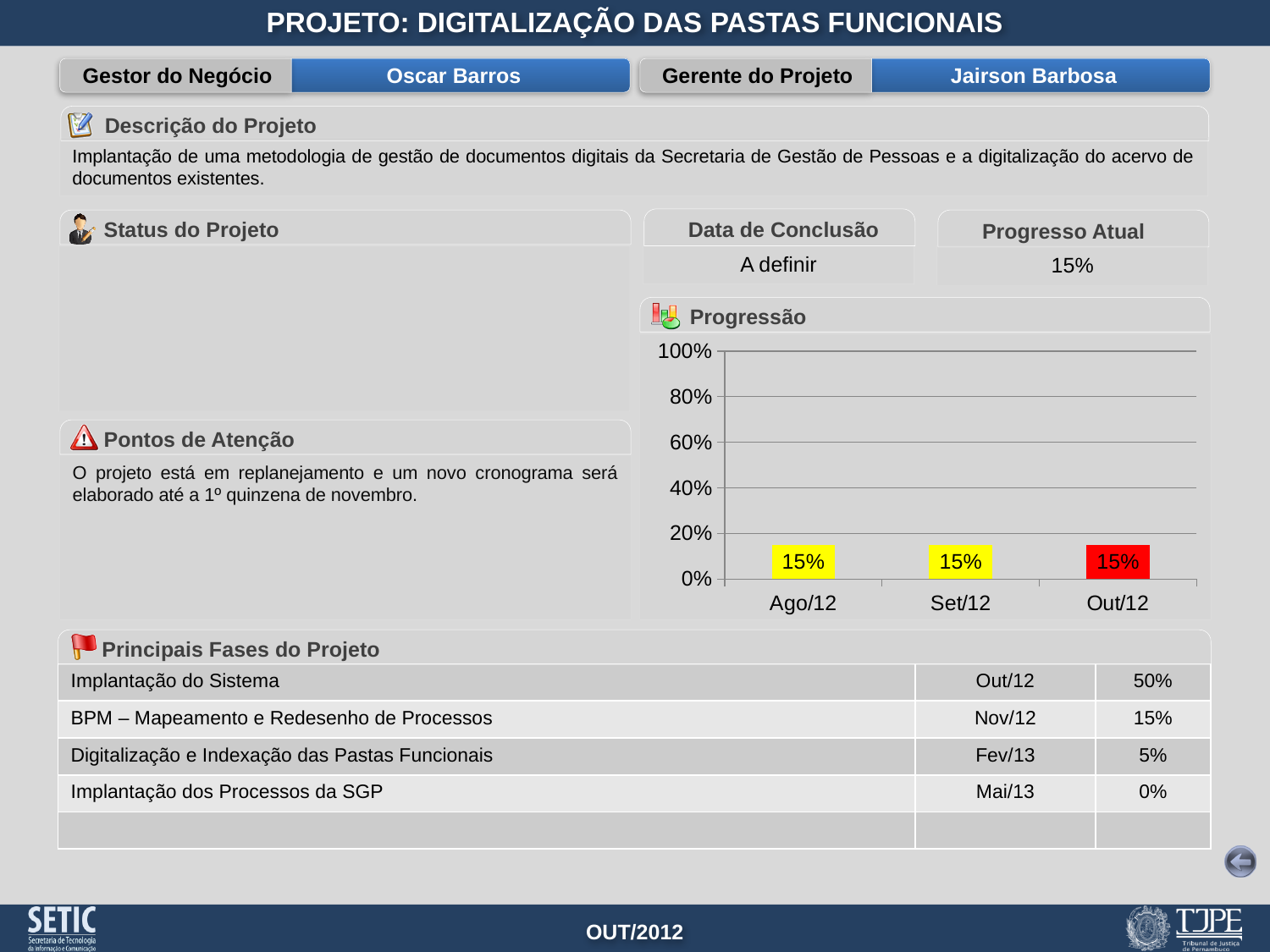
How many months are plotted in the Progressão chart? 3 What is the value for Ago/12 in the Progressão chart? 15% Is the value for Out/12 in the Progressão chart greater or less than 20%? less What is the difference between the values for Set/12 and Ago/12 in the Progressão chart? 0% What kind of chart is the Progressão chart? bar chart Is the value for Ago/12 in the Progressão chart greater or less than 40%? less What is the highest value shown on the y axis of the Progressão chart? 100% What is the value for Set/12 in the Progressão chart? 15% What colour is the Out/12 bar in the Progressão chart? red Do the values in the Progressão chart rise, fall or stay flat from Ago/12 to Out/12? stay flat What is the value for Out/12 in the Progressão chart? 15%